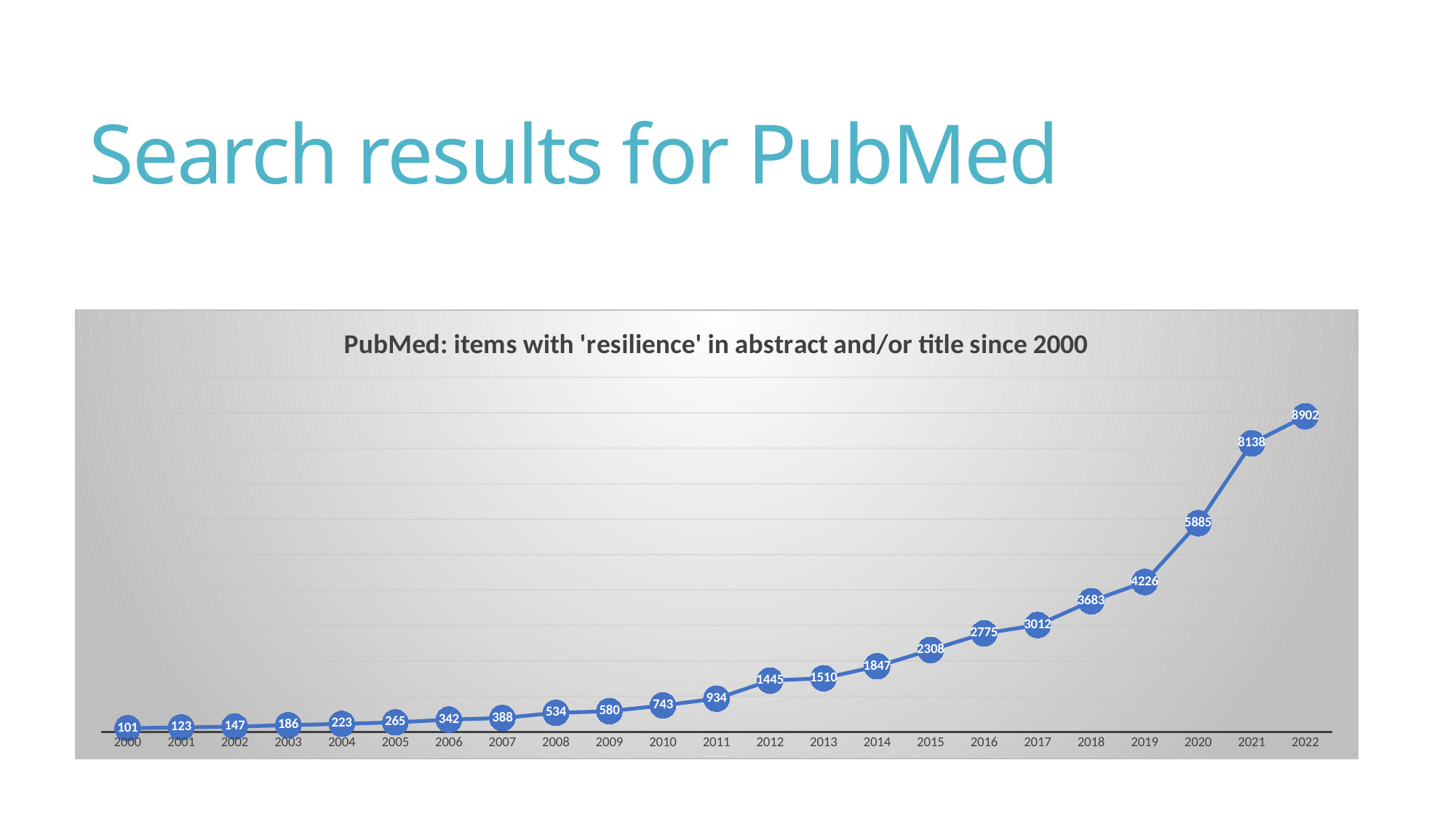
What is the value for 2022? 8902 What kind of chart is shown? line chart What is the difference between the values for 2022 and 2021? 764 What is the value for 2019? 4226 What is the value for 2010? 743 What is the value for 2000? 101 Which is larger, the value for 2015 or the value for 2016? 2016 Which year has the highest value? 2022 How many years are plotted on the chart? 23 Do the values rise or fall from 2000 to 2022? rise What is the difference between the values for 2020 and 2019? 1659 Which year has the lowest value? 2000